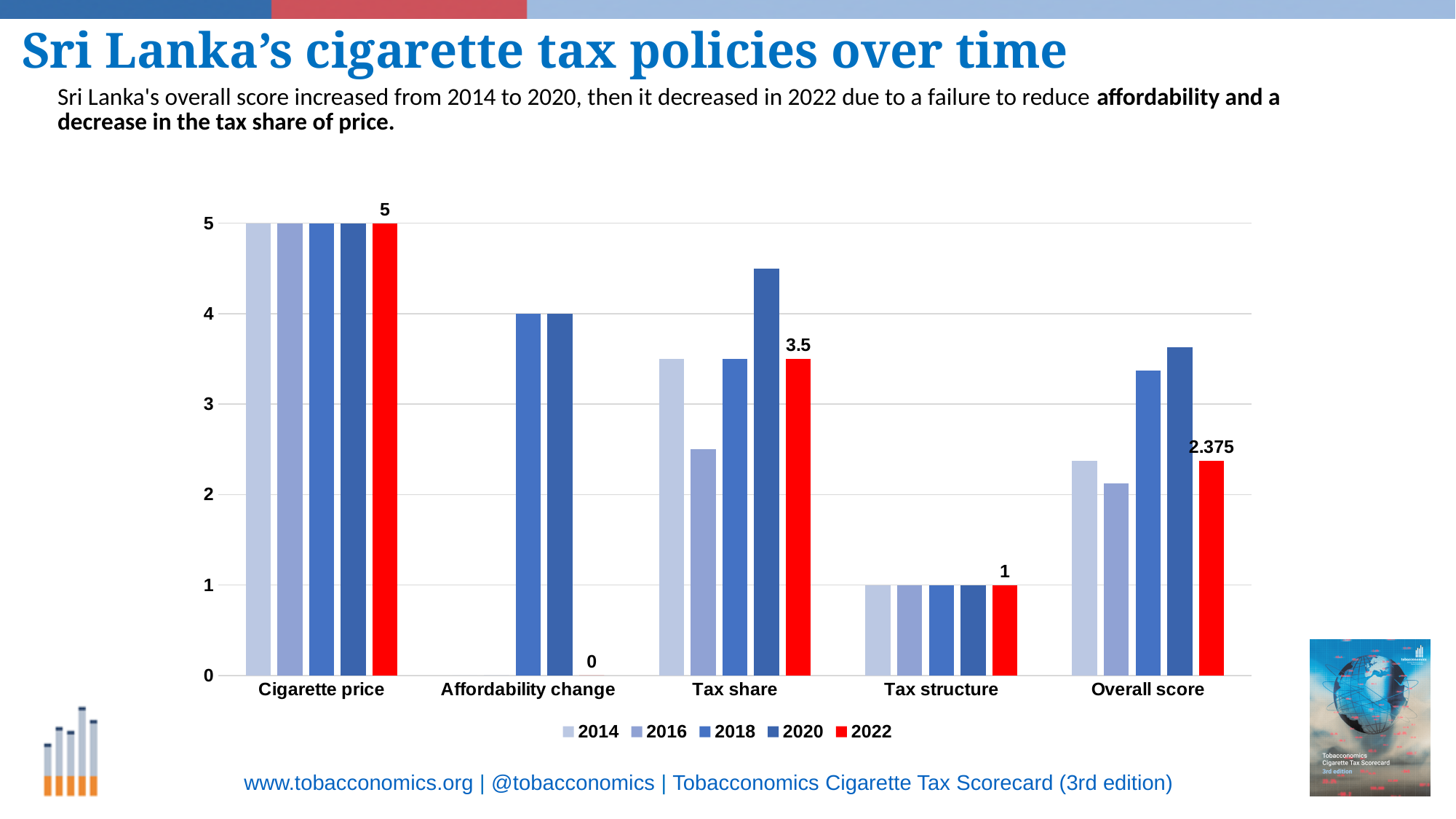
What is the value for the 2022 series in the Tax share category? 3.5 Is the 2018 value in the Overall score category greater or less than 3? greater In the Tax share category, which is larger: the 2020 value or the 2016 value? 2020 Within the Tax share category, which year has the highest value? 2020 What is the value for the 2022 series in the Overall score category? 2.375 Within the Overall score category, which year has the highest value? 2020 What is the value for the 2022 series in the Cigarette price category? 5 What is the value for the 2022 series in the Tax structure category? 1 How many series does the legend list? 5 Within the Overall score category, which year has the lowest value? 2016 What is the value for the 2022 series in the Affordability change category? 0 How many categories are shown on the x axis of the chart? 5